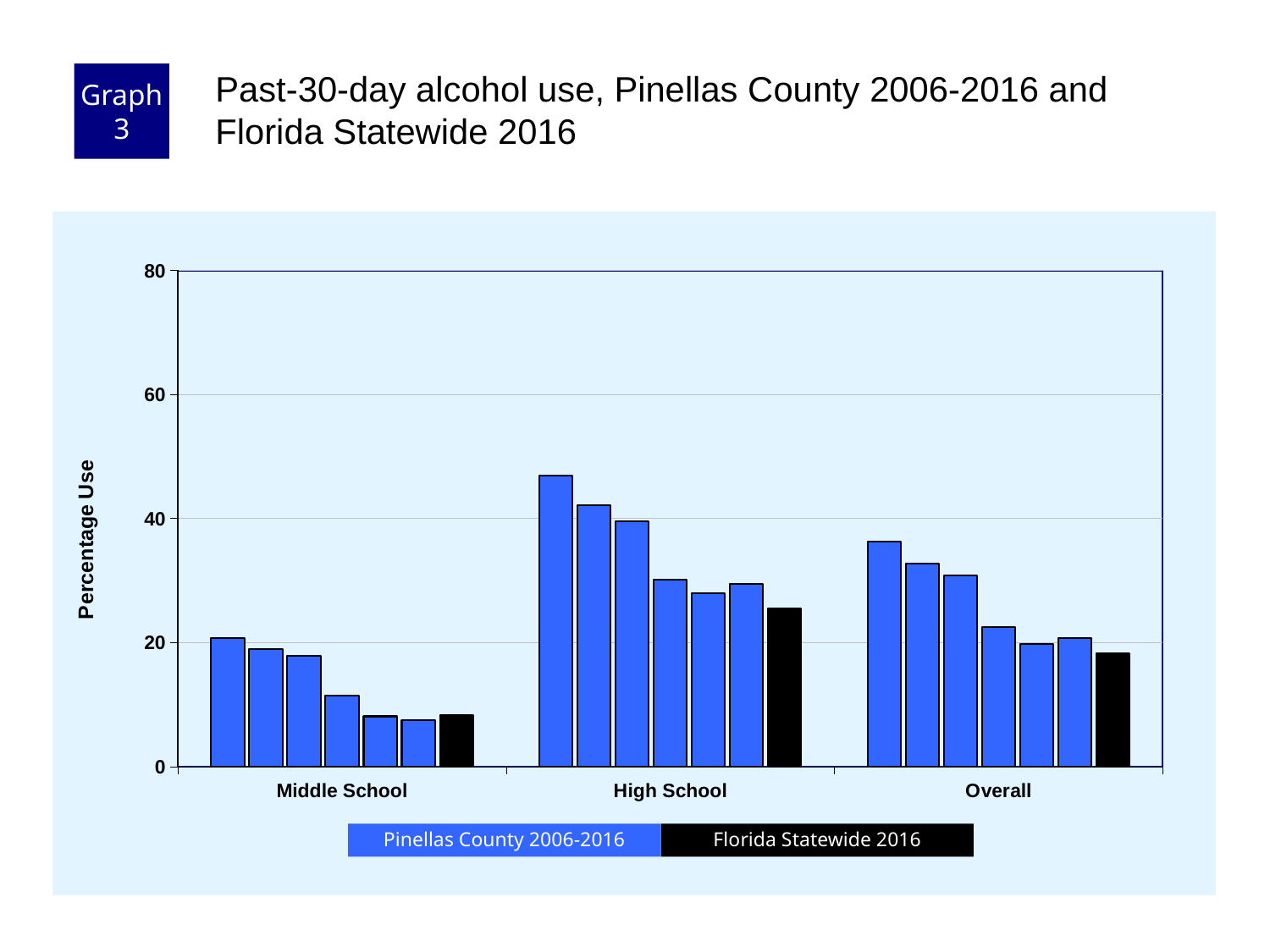
Is the value of the tallest Pinellas County bar for High School greater or less than 40? greater Is the Florida Statewide 2016 value for High School greater or less than 40? less Within the High School group, do the Pinellas County bars generally rise or fall from left to right? fall Which colour represents Florida Statewide 2016 in the chart? black Which category has the shortest bars overall? Middle School Which is larger, the Florida Statewide 2016 value for High School or for Middle School? High School What is the label on the y axis? Percentage Use How many series does the legend list? 2 What kind of chart is shown on the slide? bar chart Which category has the tallest bars overall? High School How many school-level categories are shown on the x axis? 3 Is the Florida Statewide 2016 value for Middle School greater or less than 20? less